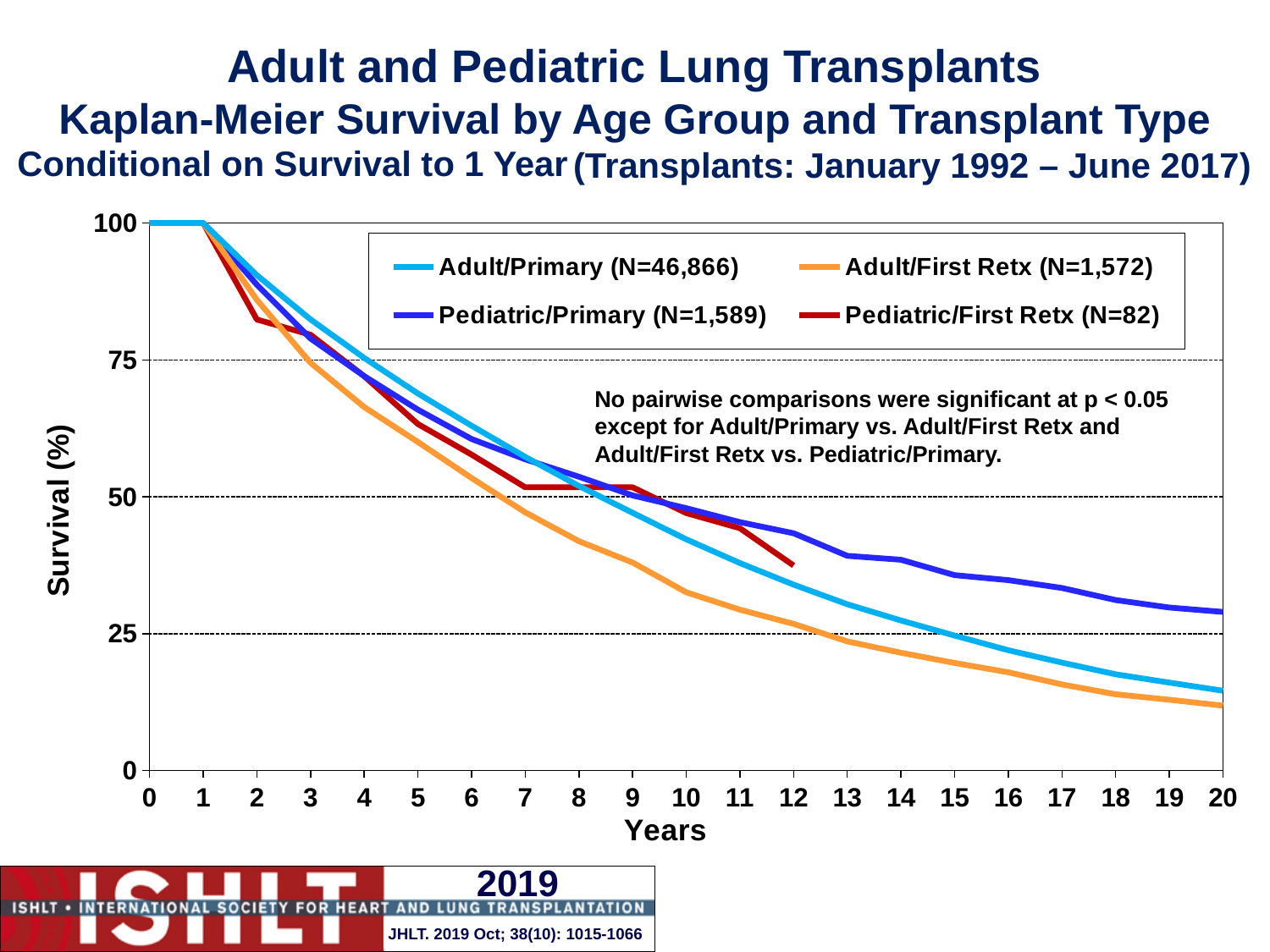
Is the survival value for Adult/Primary at year 10 greater or less than 50? less According to the legend, what is the N for the Pediatric/First Retx series? 82 How many series does the legend list? 4 Is the survival value for Pediatric/Primary at year 20 greater or less than 25? greater Which series has the highest survival at year 20? Pediatric/Primary Do the survival curves rise or fall as the years increase? fall What is the survival value for all series at year 0? 100 What kind of chart is shown on the slide? line chart Is the survival value for Adult/First Retx at year 20 greater or less than 25? less At year 15, which series has higher survival: Pediatric/Primary or Adult/Primary? Pediatric/Primary Which series has the lowest survival at year 20? Adult/First Retx